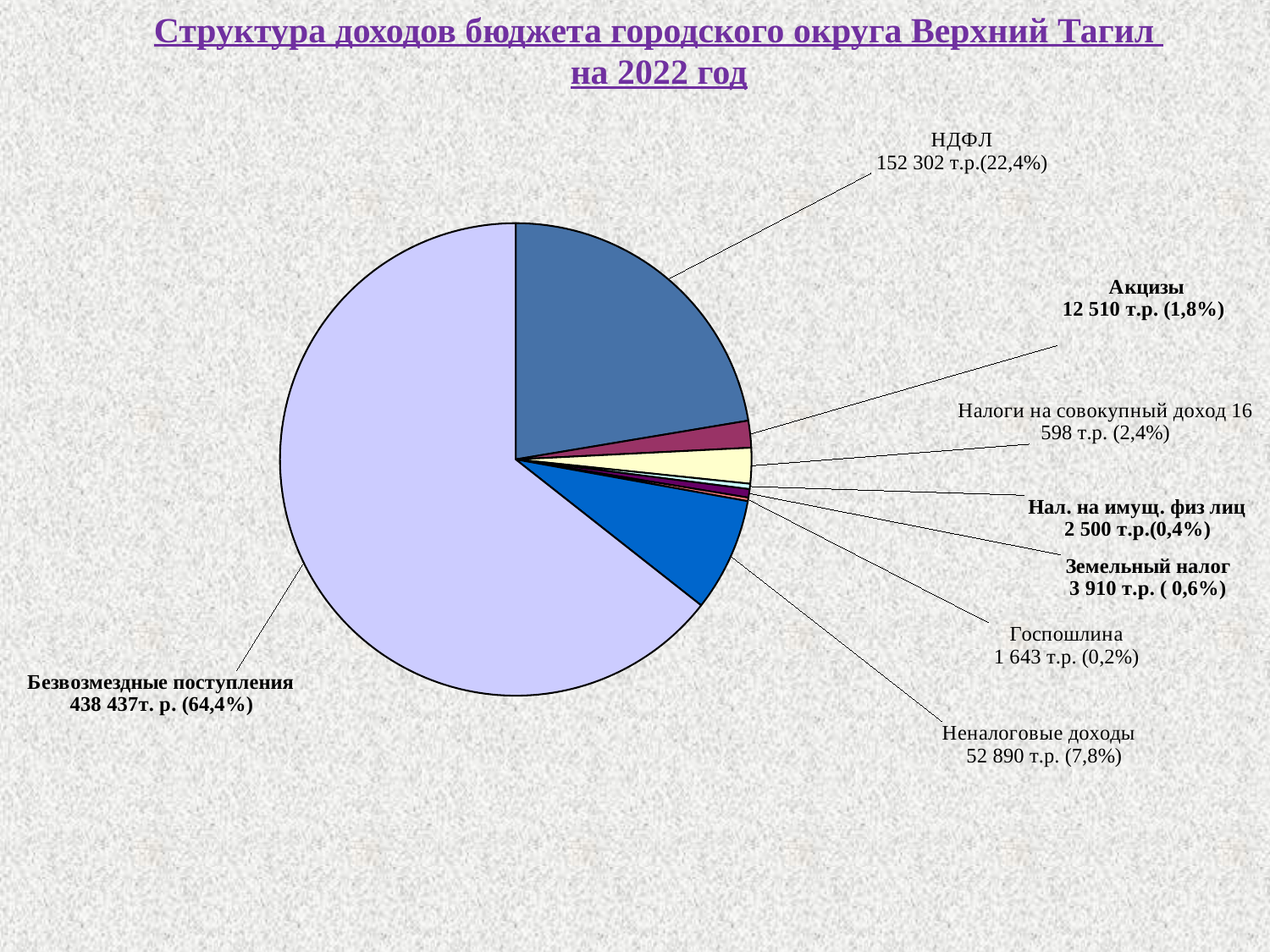
What share of the pie does Безвозмездные поступления represent? 64,4% Which is larger, Земельный налог or Нал. на имущ. физ лиц? Земельный налог Which category has the smallest share of the pie? Госпошлина What is the difference between the values for НДФЛ and Неналоговые доходы? 99 412 т.р. What is the value shown for НДФЛ? 152 302 т.р. What share of the pie does Налоги на совокупный доход represent? 2,4% What is the value shown for Акцизы? 12 510 т.р. What is the title of the chart? Структура доходов бюджета городского округа Верхний Тагил на 2022 год How many slices does the pie chart have? 8 What is the value shown for Неналоговые доходы? 52 890 т.р. What kind of chart is shown on the slide? Pie chart Which category has the largest share of the pie? Безвозмездные поступления